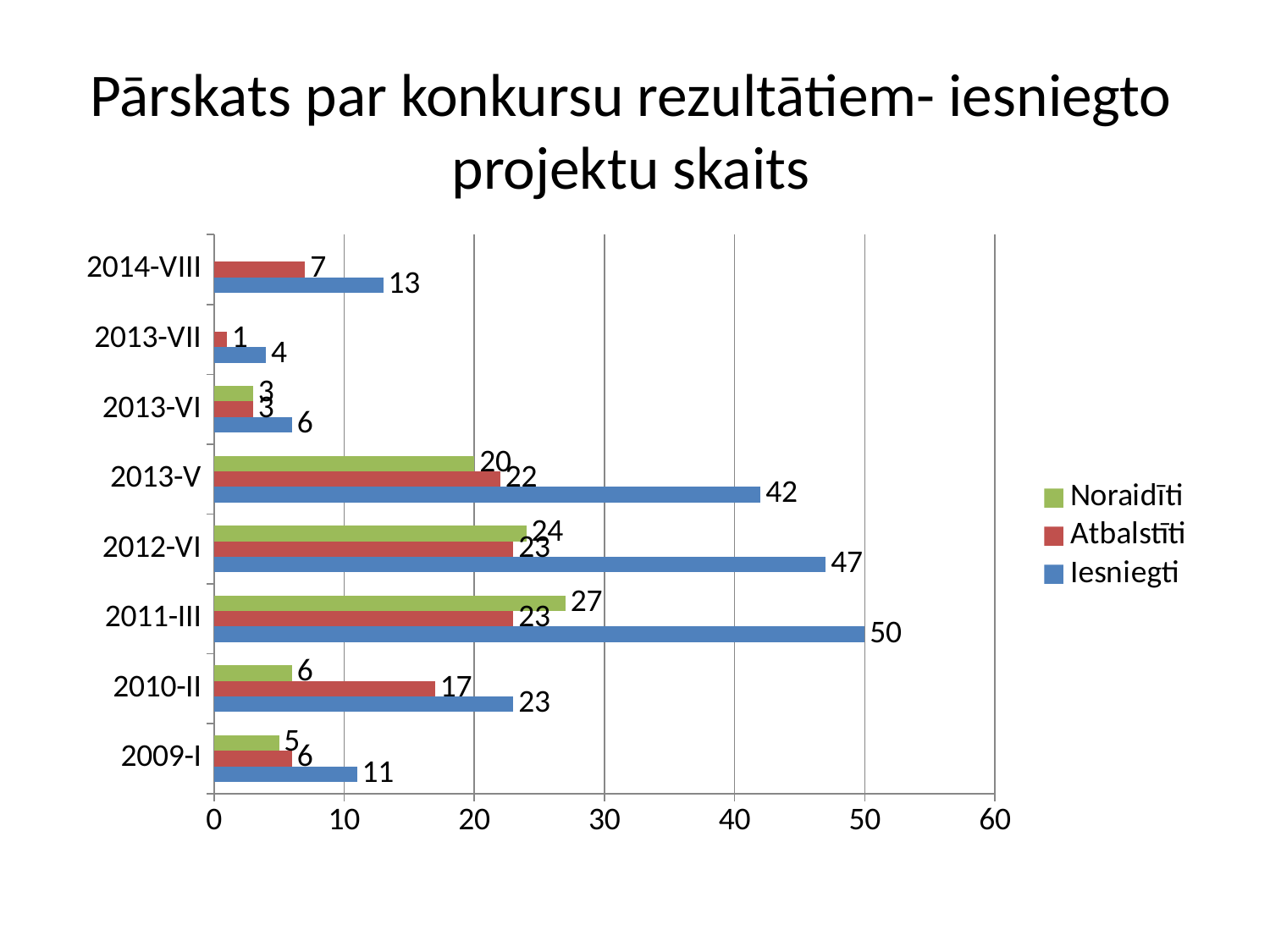
What is the Noraidīti value for 2013-V? 20 What type of chart is shown on the slide? bar chart Is the Iesniegti value for 2013-V greater or less than 40? greater Which is larger for 2010-II, the Atbalstīti value or the Noraidīti value? Atbalstīti Which category has the lowest Iesniegti value? 2013-VII Which category has the highest Iesniegti value? 2011-III What is the Atbalstīti value for 2010-II? 17 Which series is shown in blue in the legend? Iesniegti How many categories are shown on the vertical axis? 8 How many series does the legend list? 3 What is the difference between the Iesniegti and Atbalstīti values for 2012-VI? 24 What is the Iesniegti value for 2011-III? 50